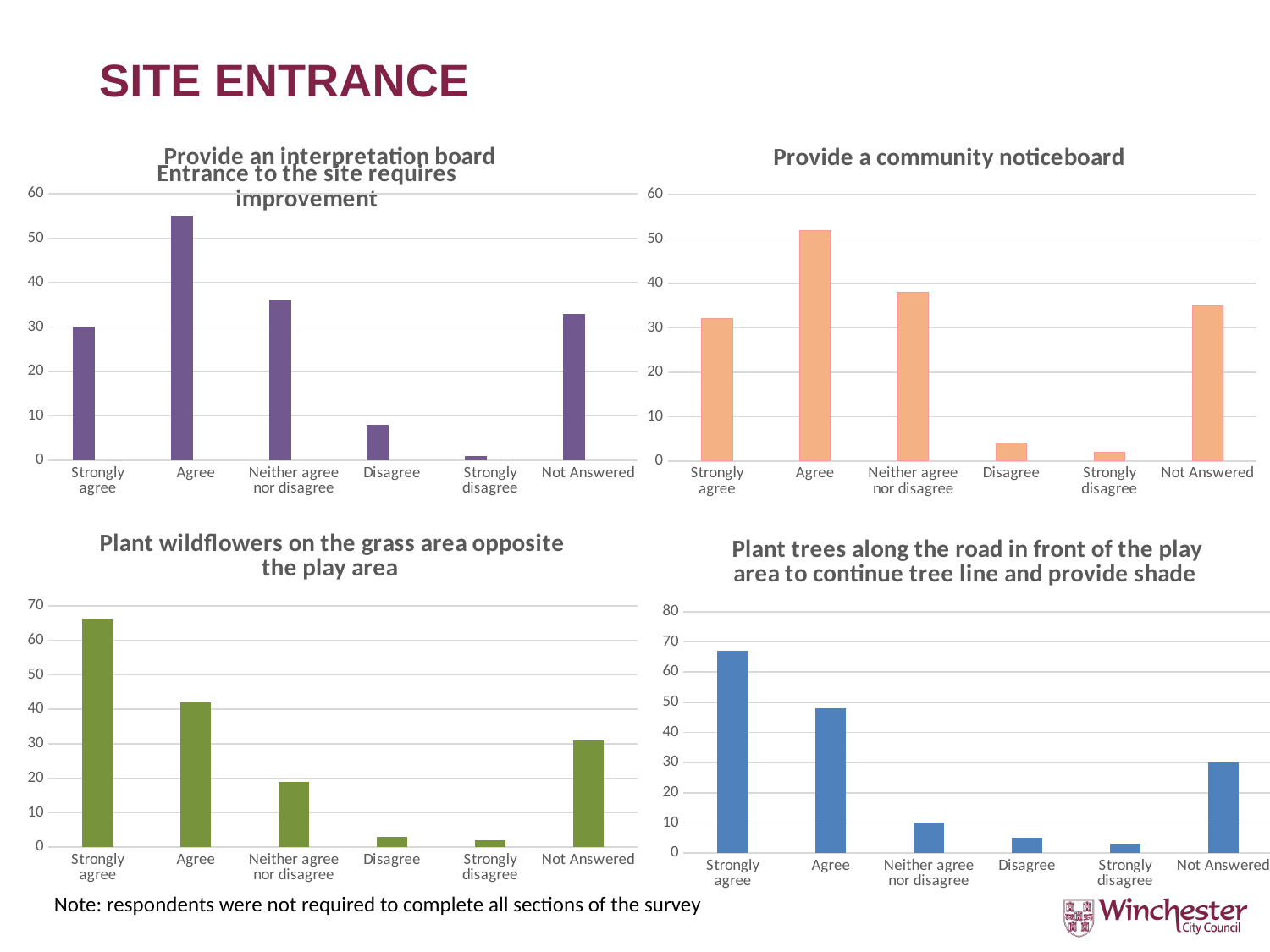
How many categories are shown on the x axis of the 'Provide a community noticeboard' chart? 6 In the 'Plant trees along the road in front of the play area to continue tree line and provide shade' chart, which category has the highest value? Strongly agree In the 'Plant wildflowers on the grass area opposite the play area' chart, which category has the highest value? Strongly agree In the top-left chart, is the value for Agree greater or less than 50? greater In the 'Provide a community noticeboard' chart, which is larger: Agree or Neither agree nor disagree? Agree In the 'Plant wildflowers on the grass area opposite the play area' chart, which is larger: Agree or Not Answered? Agree In the 'Provide a community noticeboard' chart, which category has the highest value? Agree What kind of chart is the top-left chart on the slide? bar chart In the 'Provide a community noticeboard' chart, is the value for Neither agree nor disagree greater or less than 40? less What colour are the bars in the 'Plant trees along the road in front of the play area to continue tree line and provide shade' chart? blue In the top-left chart, which category has the lowest value? Strongly disagree